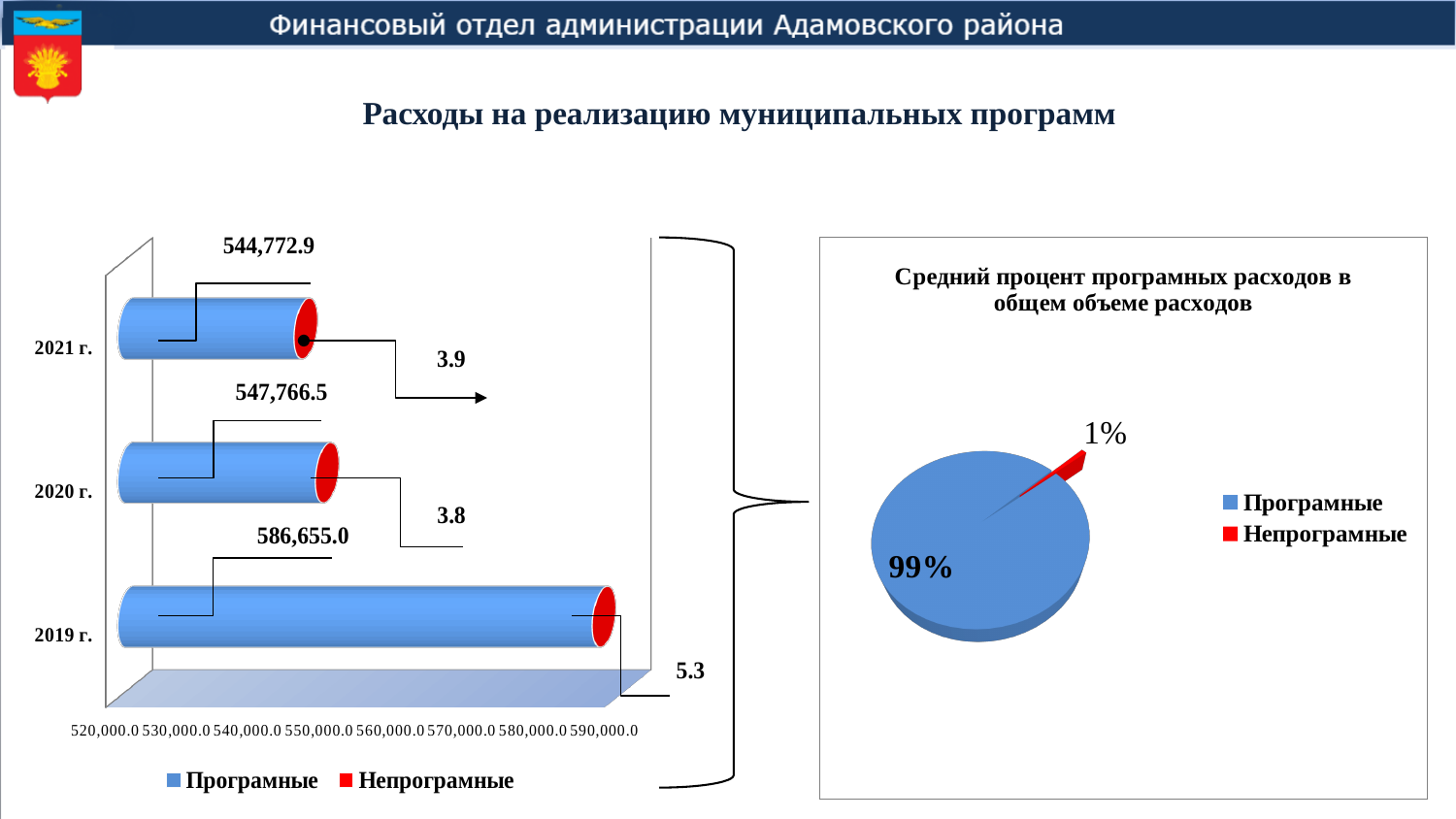
In the bar chart on the left, what is the value of the Програмные series for 2021 г.? 544,772.9 In the bar chart on the left, what is the value of the Непрограмные series for 2019 г.? 5.3 What type of chart is shown on the left of the slide? bar chart In the bar chart on the left, which year has the lowest Непрограмные value? 2020 г. In the bar chart on the left, what is the difference between the Програмные values for 2019 г. and 2021 г.? 41,882.1 In the bar chart on the left, is the Програмные value for 2020 г. larger or smaller than for 2021 г.? larger In the bar chart on the left, which year has the highest Програмные value? 2019 г. In the pie chart on the right, what share does the Програмные slice have? 99% In the bar chart on the left, what is the value of the Програмные series for 2020 г.? 547,766.5 In the bar chart on the left, how many years are shown? 3 What is the title of the pie chart on the right? Средний процент програмных расходов в общем объеме расходов In the bar chart on the left, how many series does the legend list? 2